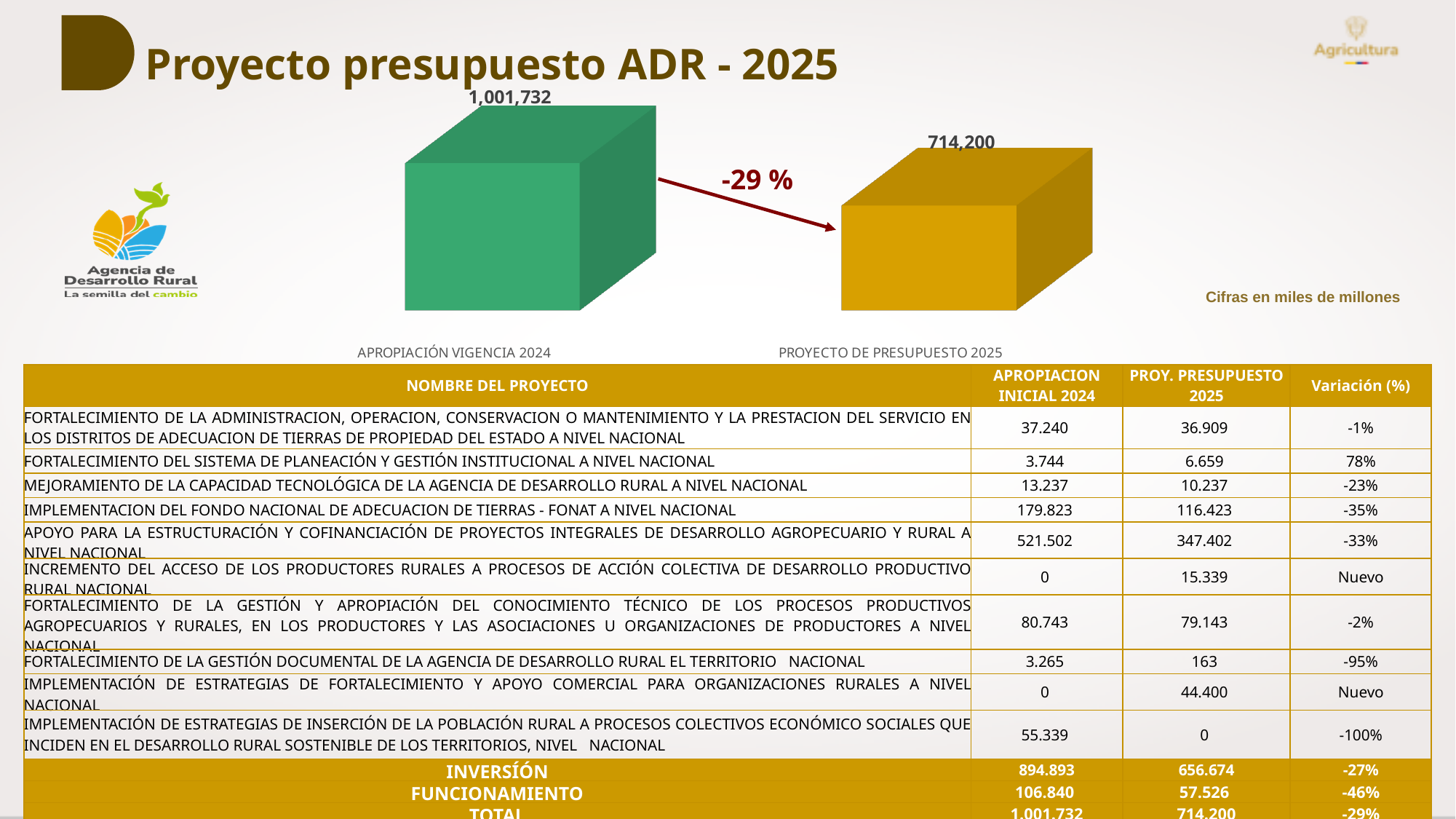
Which category has the highest value in the chart? APROPIACIÓN VIGENCIA 2024 What kind of chart is shown on the slide? Bar chart What is the value shown for APROPIACIÓN VIGENCIA 2024 in the chart? 1,001,732 Which is larger, the value for APROPIACIÓN VIGENCIA 2024 or the value for PROYECTO DE PRESUPUESTO 2025? APROPIACIÓN VIGENCIA 2024 What percentage change is annotated on the arrow between the two bars? -29 % What colour is the bar for PROYECTO DE PRESUPUESTO 2025? Yellow/gold How many bars are plotted in the chart? 2 What is the value shown for PROYECTO DE PRESUPUESTO 2025 in the chart? 714,200 What is the difference between the value for APROPIACIÓN VIGENCIA 2024 and the value for PROYECTO DE PRESUPUESTO 2025? 287,532 Which category has the lowest value in the chart? PROYECTO DE PRESUPUESTO 2025 Do the values rise or fall from APROPIACIÓN VIGENCIA 2024 to PROYECTO DE PRESUPUESTO 2025? Fall